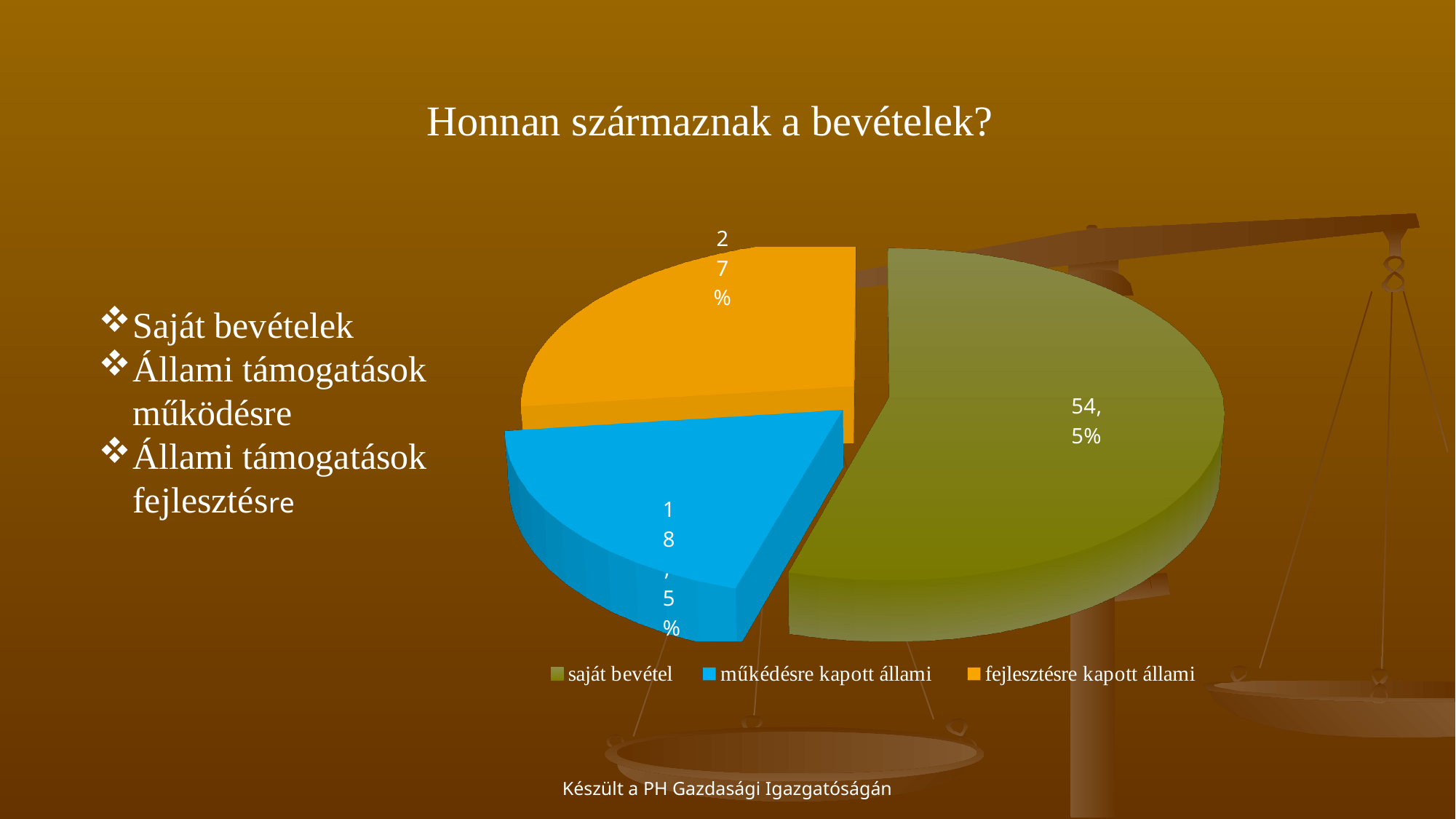
What share of the pie does "műkédésre kapott állami" have? 18,5% Which category has the largest slice of the pie? saját bevétel What share of the pie does "saját bevétel" have? 54,5% What is the difference in percentage points between the "fejlesztésre kapott állami" slice and the "műkédésre kapott állami" slice? 8,5 What colour is the "saját bevétel" slice in the pie chart? green How many slices does the pie chart have? 3 Which is larger, the slice for "fejlesztésre kapott állami" or the slice for "műkédésre kapott állami"? fejlesztésre kapott állami How many entries does the legend list? 3 What kind of chart is shown on the slide? pie chart Which category has the smallest slice of the pie? műkédésre kapott állami What is the difference in percentage points between the "saját bevétel" slice and the "fejlesztésre kapott állami" slice? 27,5 What share of the pie does "fejlesztésre kapott állami" have? 27%